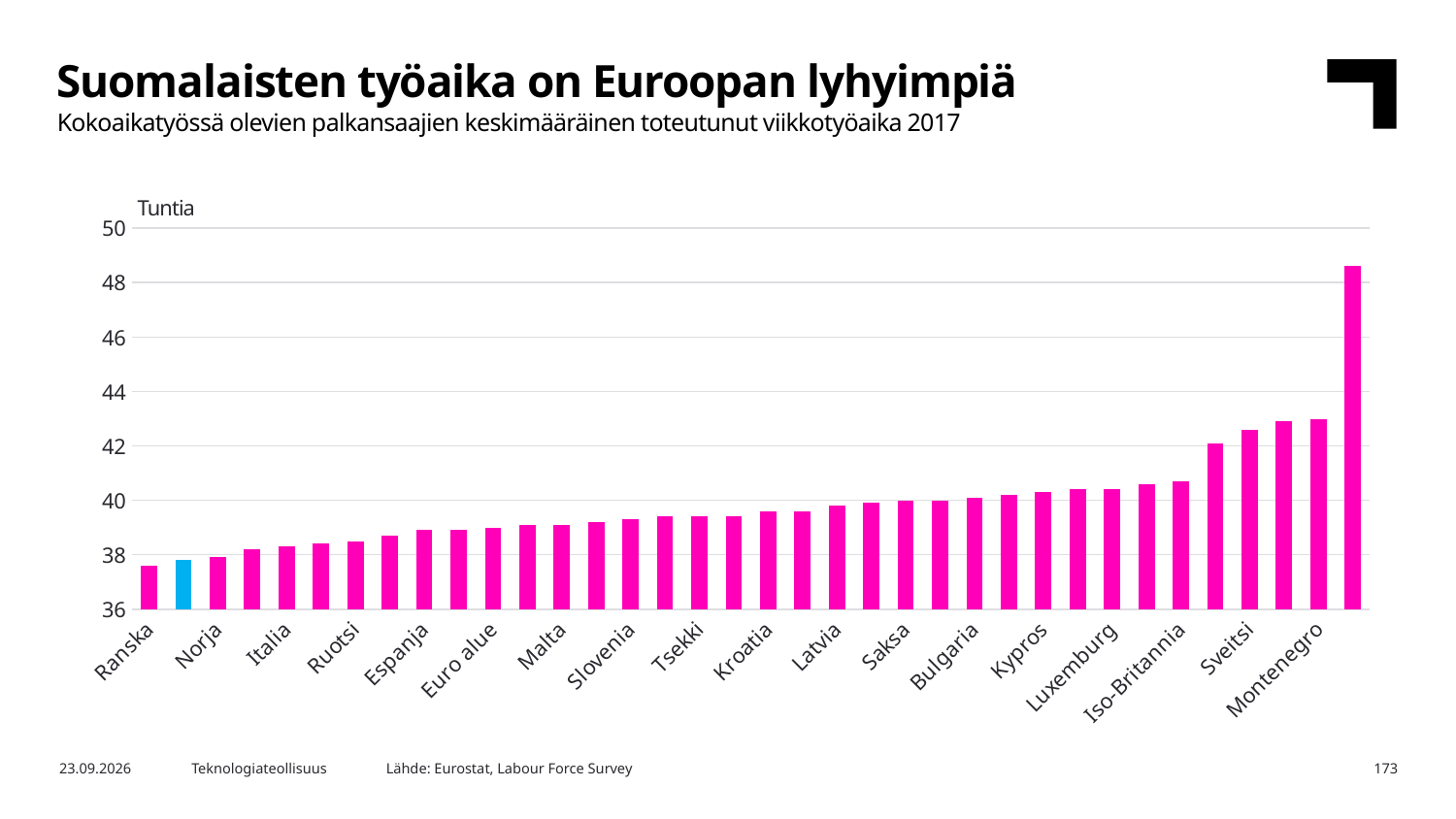
Which has a larger value, Ranska or Montenegro? Montenegro What kind of chart is shown on the slide? bar chart What unit is shown at the top of the y axis? Tuntia Is the value for Kypros greater or less than 40? greater Which has a larger value, Sveitsi or Malta? Sveitsi Is the value for Iso-Britannia greater or less than 40? greater Is the value for Montenegro greater or less than 44? less Do the values rise or fall from left to right along the x axis? rise